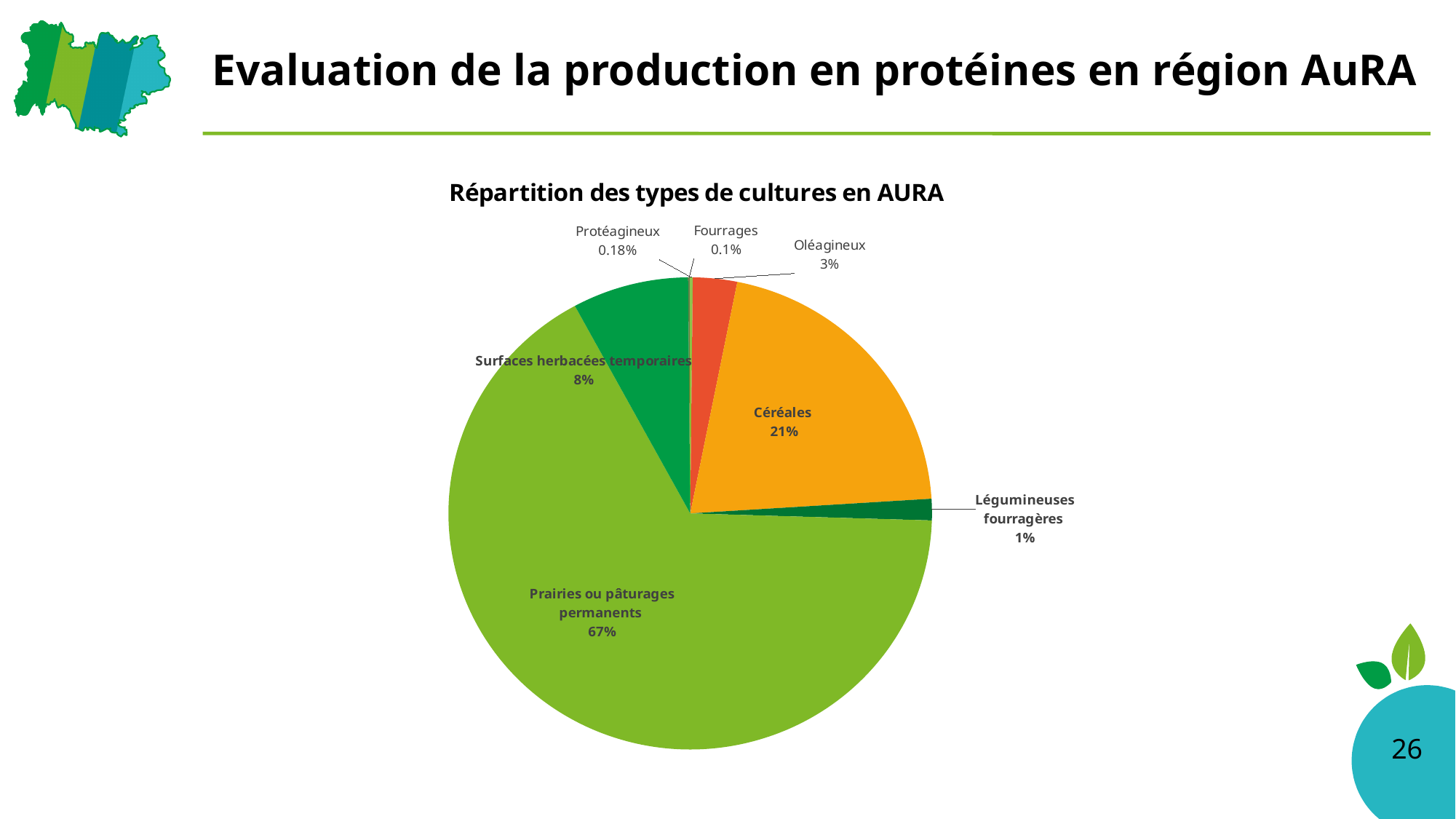
Which is larger, the share for Oléagineux or the share for Légumineuses fourragères? Oléagineux How many categories are shown in the pie chart? 7 Which category has the smallest share of the pie? Fourrages What percentage is shown for Protéagineux? 0.18% What percentage is shown for Surfaces herbacées temporaires? 8% What is the title of the chart? Répartition des types de cultures en AURA What is the difference in percentage points between Céréales and Surfaces herbacées temporaires? 13 What share of the pie does Prairies ou pâturages permanents represent? 67% What is the value shown for Fourrages? 0.1% What is the value shown for Céréales? 21% What is the value shown for Oléagineux? 3% Which category has the largest share of the pie? Prairies ou pâturages permanents